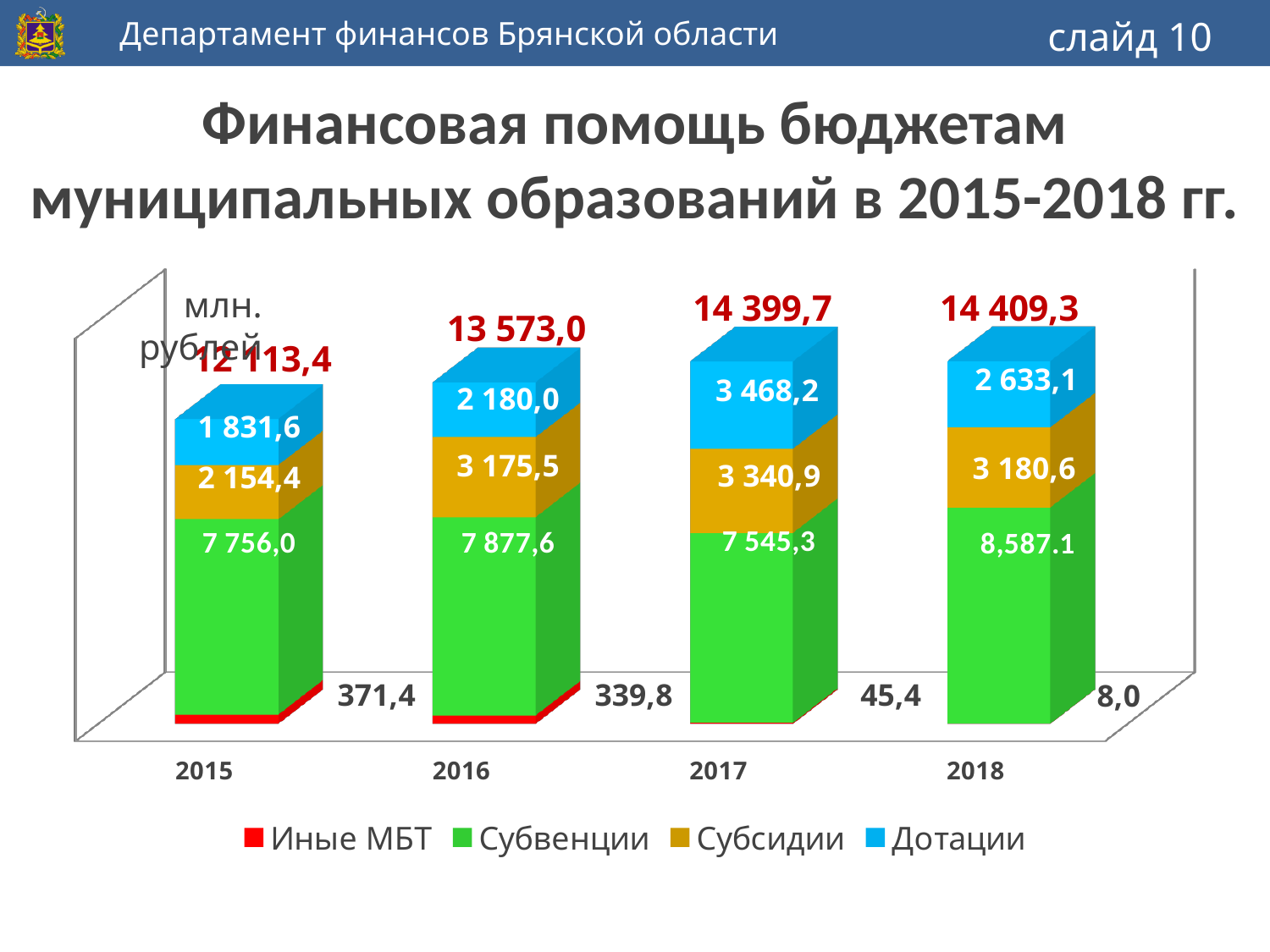
What is the value of Субвенции for 2016? 7 877,6 What is the difference between the Дотации values for 2017 and 2015? 1 636,6 What is the value of Дотации for 2018? 2 633,1 In which year is the value of Иные МБТ the lowest? 2018 How many series does the legend list? 4 Which is larger: Субсидии in 2017 or Субсидии in 2018? Субсидии in 2017 How many years (categories) are shown on the x axis? 4 What is the total of the stacked bar for 2017? 14 399,7 What is the value of Иные МБТ for 2015? 371,4 In which year is the value of Дотации the highest? 2017 Do the bar totals rise or fall from 2015 to 2018? Rise What kind of chart is shown on the slide? Stacked bar chart